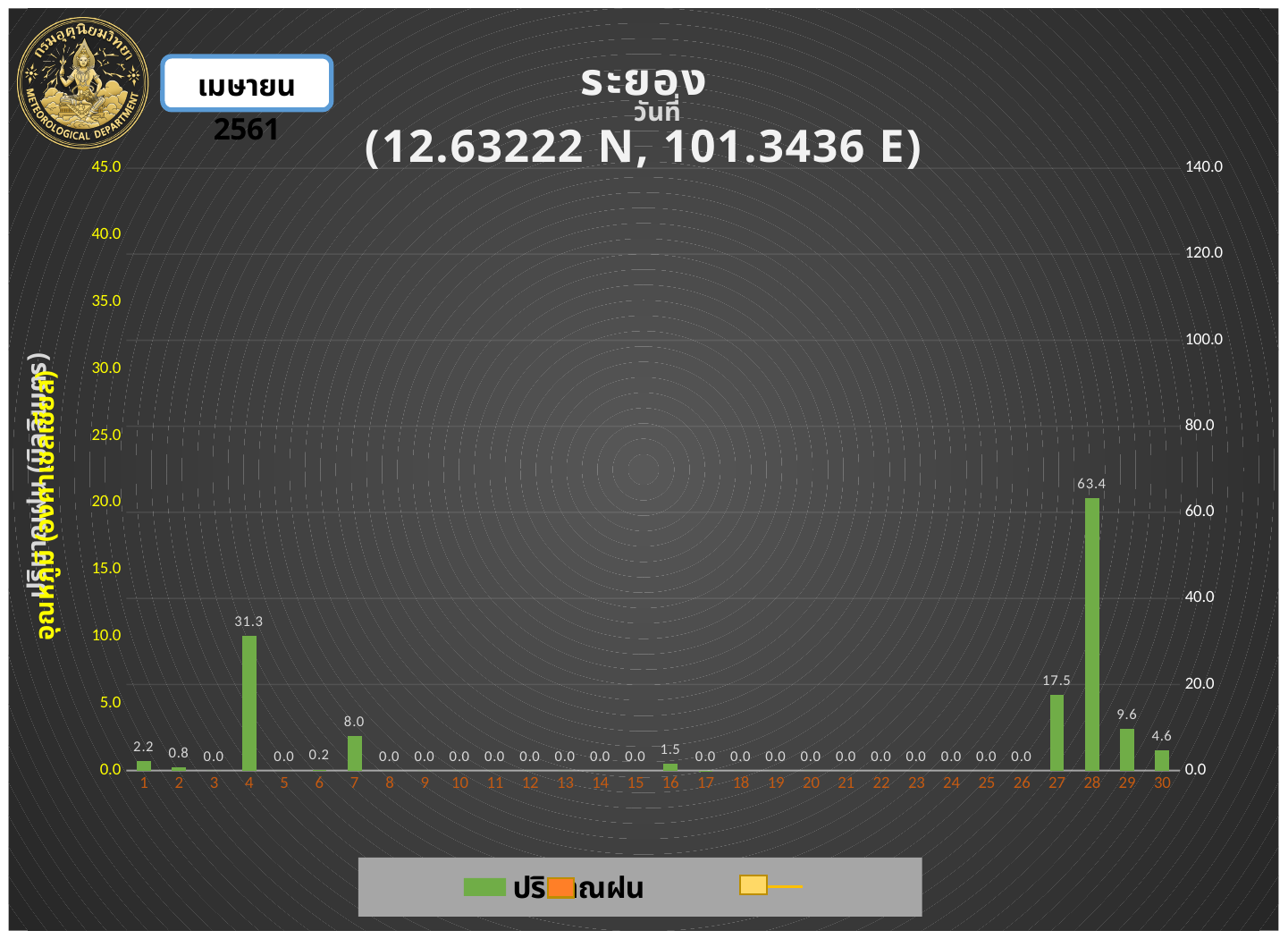
What is the rainfall value shown for day 28? 63.4 What is the value shown for day 16? 1.5 What are the coordinates shown in the chart title? (12.63222 N, 101.3436 E) What kind of chart is shown on the slide? bar chart What is the value shown for day 27? 17.5 What is the difference between the values for day 28 and day 4? 32.1 What is the value shown for day 4? 31.3 Which day has the highest value? 28 How many days are shown on the x axis? 30 Which is larger, the value for day 27 or the value for day 29? day 27 What is the difference between the values for day 29 and day 30? 5.0 What is the value shown for day 7? 8.0